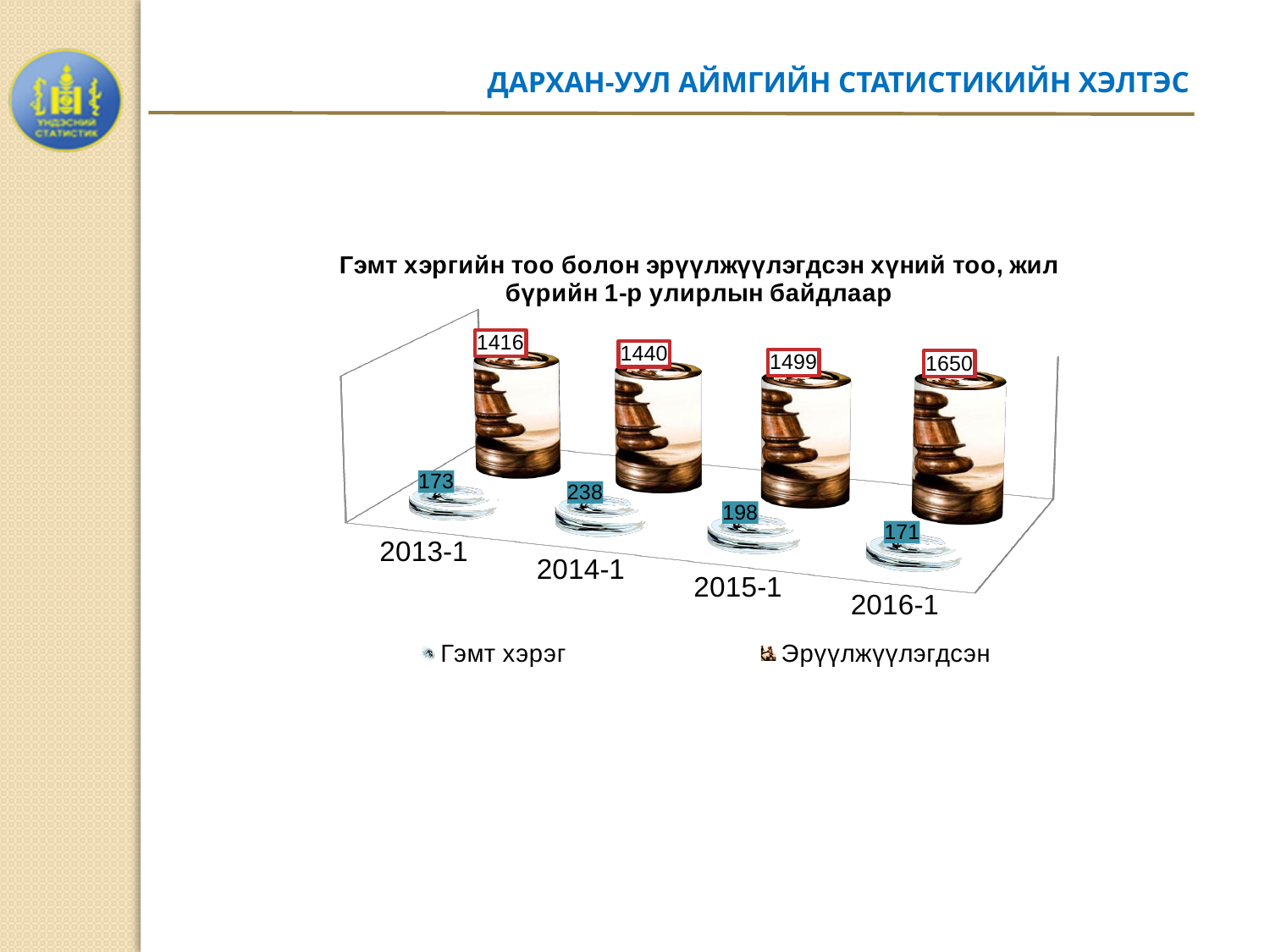
Do the Эрүүлжүүлэгдсэн values rise or fall from 2013-1 to 2016-1? Rise What kind of chart is shown on the slide? Bar chart What is the value for Эрүүлжүүлэгдсэн in 2013-1? 1416 Which period has the lowest value for Эрүүлжүүлэгдсэн? 2013-1 Which is larger, the Гэмт хэрэг value for 2013-1 or for 2016-1? 2013-1 What is the value for Гэмт хэрэг in 2014-1? 238 What is the value for Эрүүлжүүлэгдсэн in 2016-1? 1650 Which period has the highest value for Гэмт хэрэг? 2014-1 How many series does the legend list? 2 What is the value for Гэмт хэрэг in 2015-1? 198 How many periods are shown on the x axis? 4 What is the difference between the Эрүүлжүүлэгдсэн values for 2016-1 and 2015-1? 151